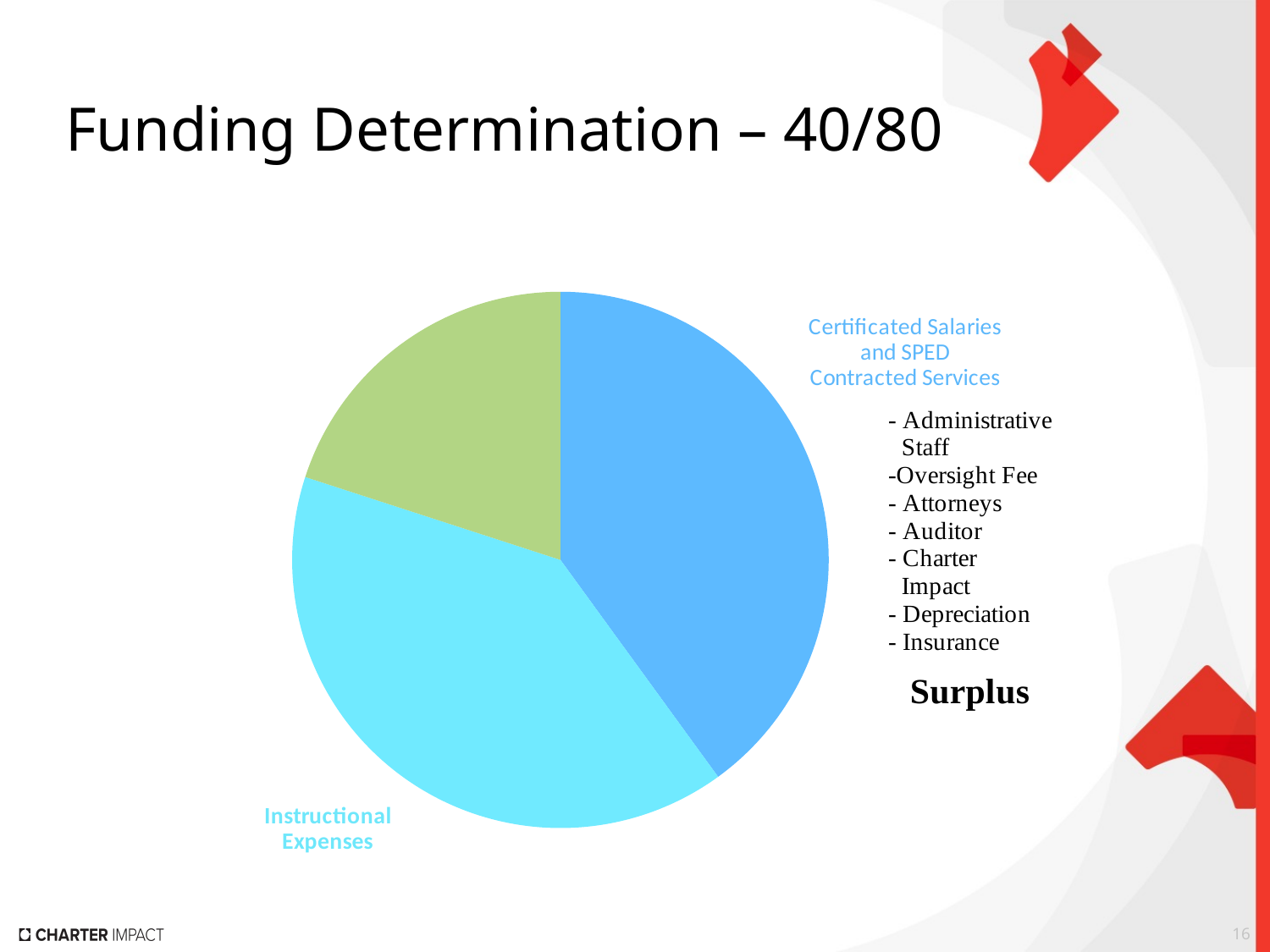
What colour is the Instructional Expenses slice of the pie chart? Light blue (cyan) Which is larger in the pie chart: the Certificated Salaries and SPED Contracted Services slice or the green slice? Certificated Salaries and SPED Contracted Services Which slice of the pie chart is the smallest? The green slice What kind of chart is shown on the slide? Pie chart Which is larger in the pie chart: the Instructional Expenses slice or the green slice? Instructional Expenses What is the title of the slide containing the pie chart? Funding Determination – 40/80 How many slices does the pie chart have? 3